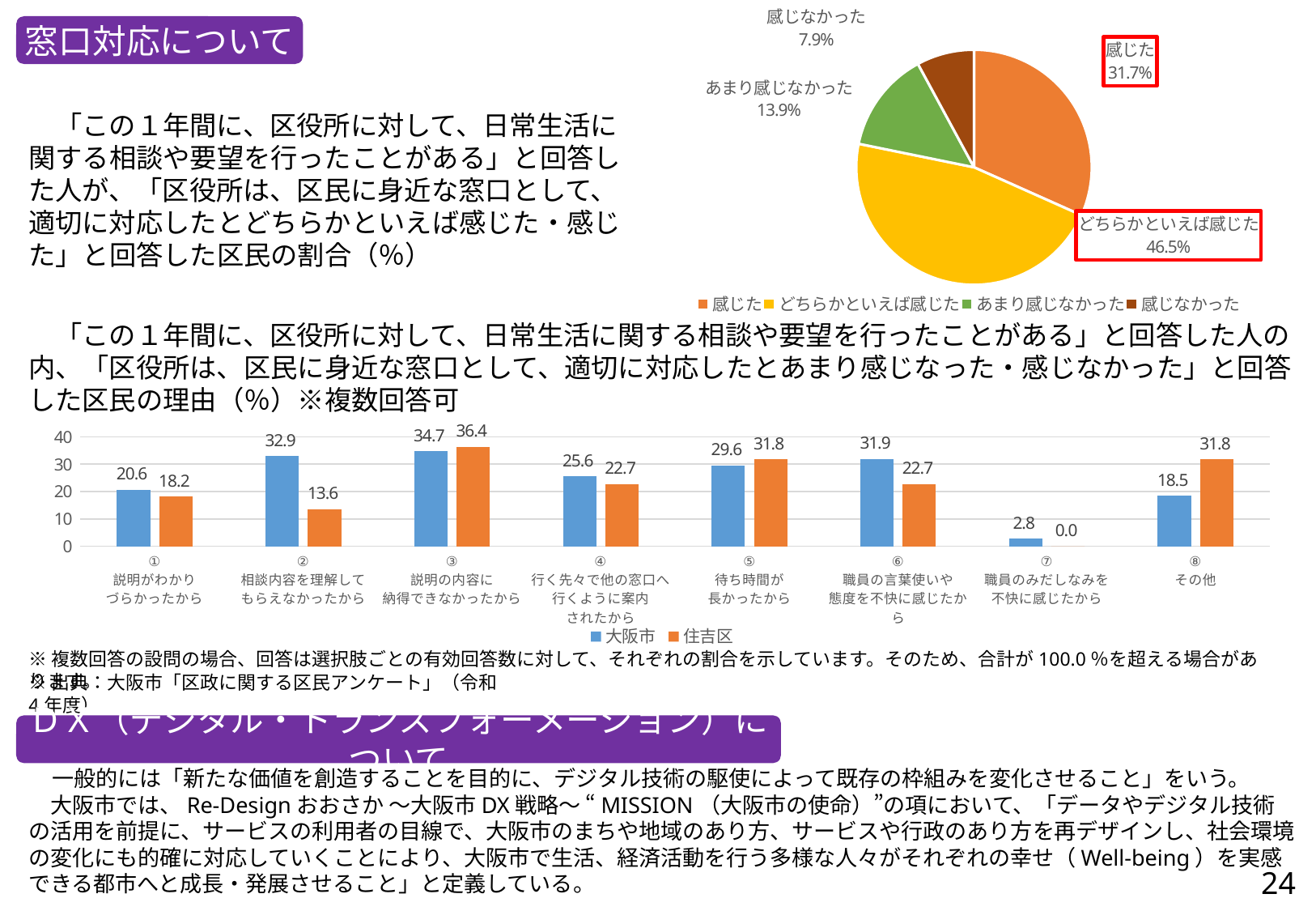
In the bar chart at the bottom, what is the difference between 大阪市 and 住吉区 in category ② 相談内容を理解してもらえなかったから? 19.3 In the pie chart at the top right, what is the combined share of 「感じた」 and 「どちらかといえば感じた」? 78.2% In the bar chart at the bottom, what is the value for 大阪市 in category ② 相談内容を理解してもらえなかったから? 32.9 In the bar chart at the bottom, which is larger in category ⑤ 待ち時間が長かったから, 大阪市 or 住吉区? 住吉区 In the bar chart at the bottom, how many series does the legend list? 2 In the pie chart at the top right, what share of respondents answered 「どちらかといえば感じた」? 46.5% In the bar chart at the bottom, which category has the lowest value for 大阪市? ⑦ 職員のみだしなみを不快に感じたから In the pie chart at the top right, which response has the largest slice? どちらかといえば感じた In the bar chart at the bottom, which category has the highest value for 住吉区? ③ 説明の内容に納得できなかったから In the bar chart at the bottom, what is the value for 住吉区 in category ⑧ その他? 31.8 In the pie chart at the top right, how many slices are there? 4 In the pie chart at the top right, what share of respondents answered 「感じなかった」? 7.9%